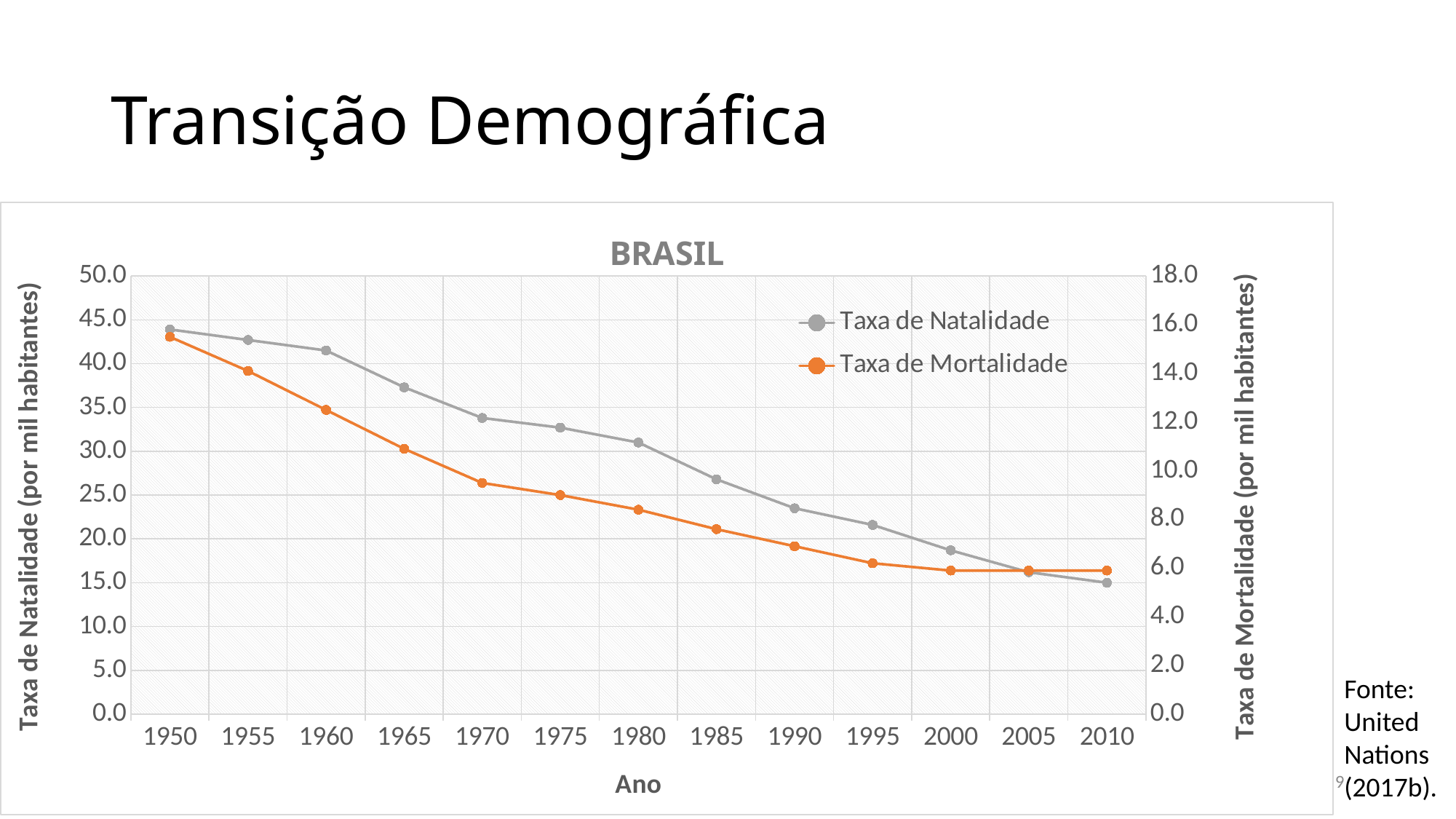
In which year is the Taxa de Natalidade highest? 1950 How many years are plotted along the x axis? 13 How many series does the legend list? 2 Is the Taxa de Natalidade in 2010 greater or less than 20.0? less What kind of chart is shown on the slide? line chart Is the Taxa de Mortalidade in 1990 greater or less than 8.0? less Is the Taxa de Natalidade in 1950 greater or less than 40.0? greater Does the Taxa de Natalidade rise or fall from 1950 to 2010? fall Which colour is used for the Taxa de Mortalidade series? orange In which year is the Taxa de Mortalidade highest? 1950 In which year is the Taxa de Natalidade lowest? 2010 What is the title of the chart? BRASIL